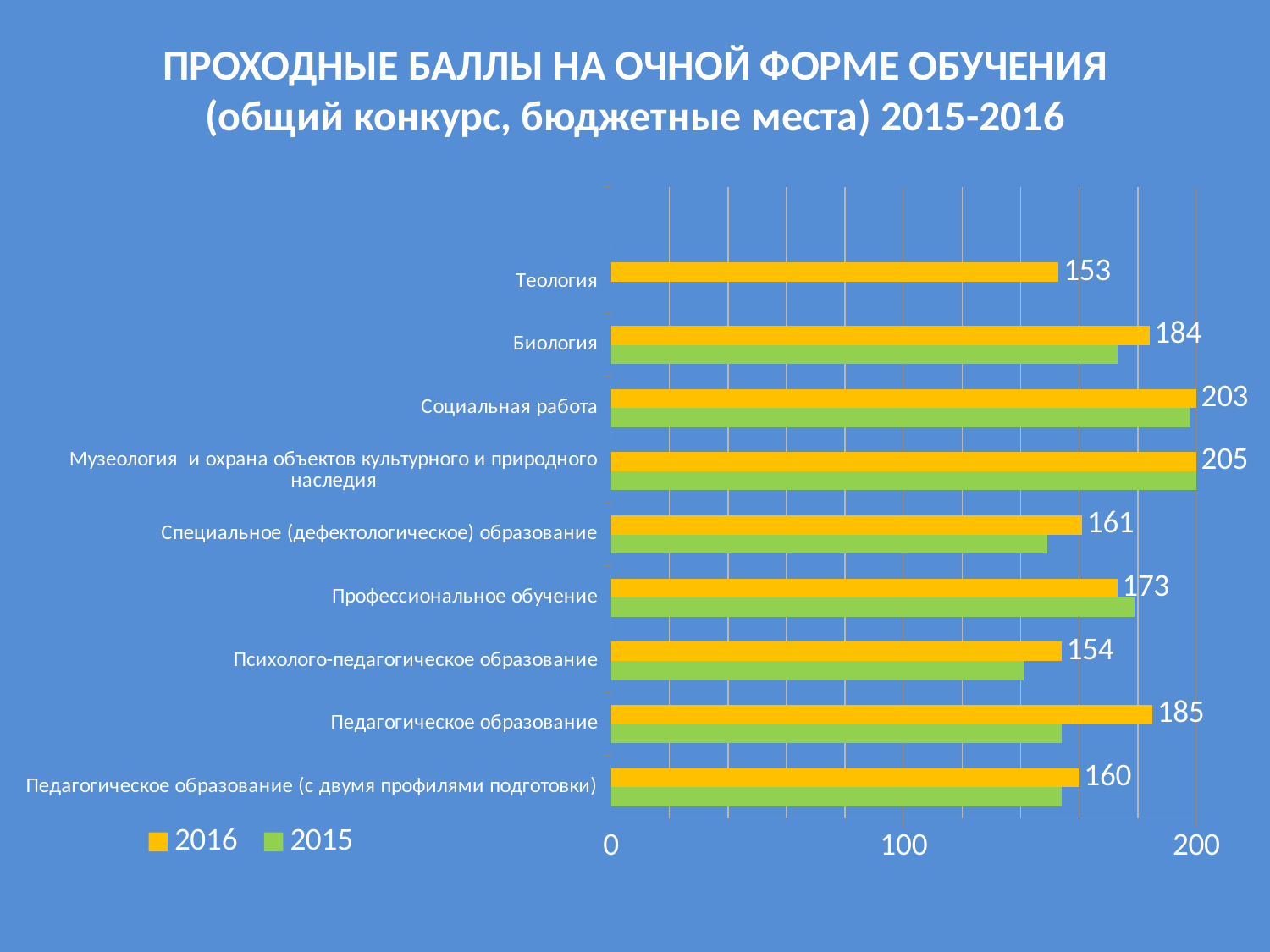
Is the 2015 value for Психолого-педагогическое образование greater or less than 100? greater Which has the larger 2016 value: Социальная работа or Профессиональное обучение? Социальная работа What is the 2016 value for Социальная работа? 203 How many categories (programmes) are shown on the chart? 9 Which category has the highest 2016 value? Музеология и охрана объектов культурного и природного наследия How many series does the legend list? 2 What is the 2016 value for Теология? 153 What type of chart is shown on the slide? bar chart What is the 2016 value for Профессиональное обучение? 173 Which category has the lowest 2016 value? Теология Which series is shown in orange according to the legend? 2016 What is the difference between the 2016 values for Музеология и охрана объектов культурного и природного наследия and Теология? 52